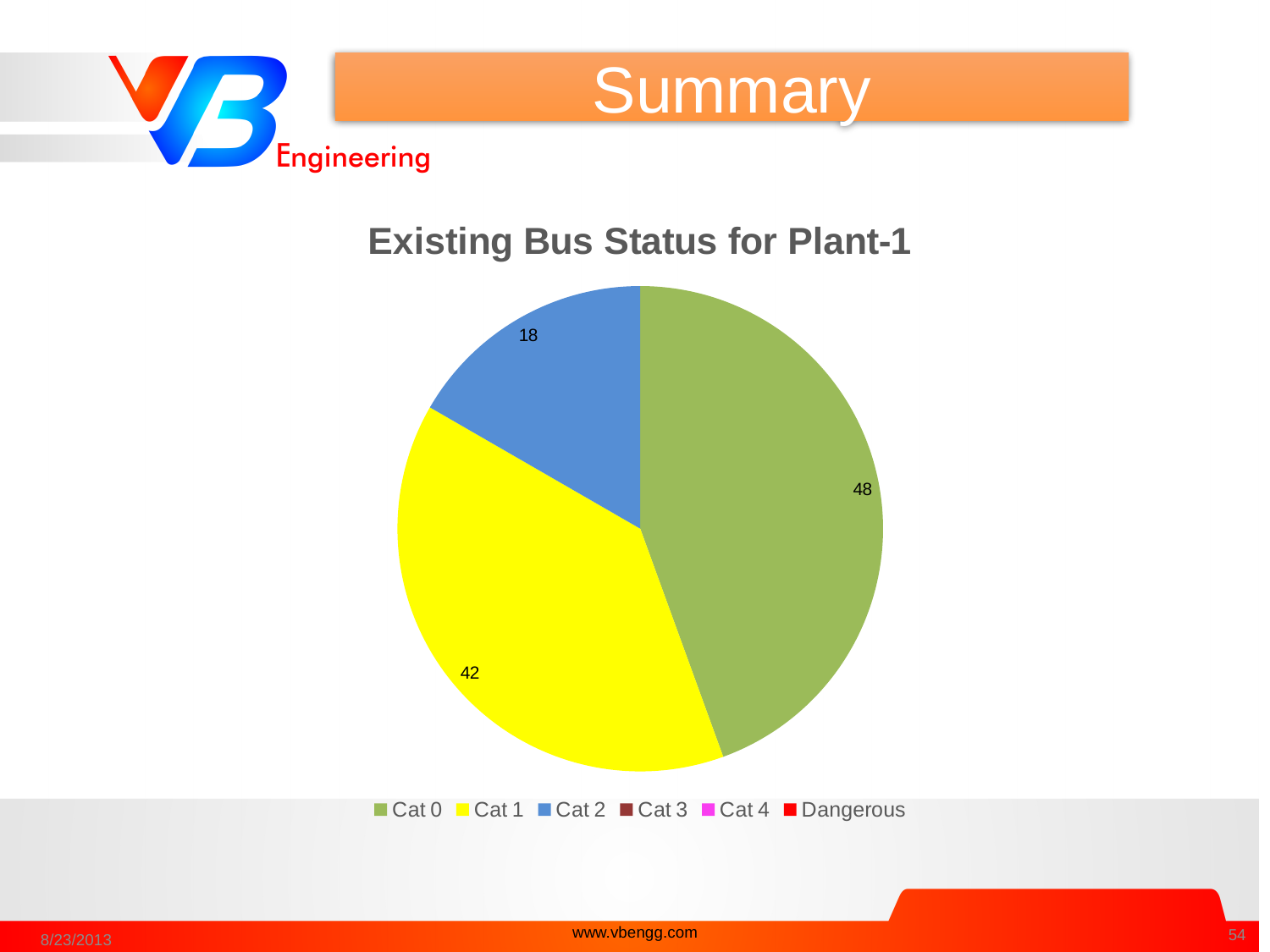
What is the value for Cat 2? 18 What is the difference between the values for Cat 0 and Cat 1? 6 What is the value for Cat 1? 42 What is the title of the chart? Existing Bus Status for Plant-1 What is the value for Cat 0? 48 How many slices with data labels are shown in the pie? 3 Which of the visible slices is the smallest? Cat 2 Which is larger, the value for Cat 1 or the value for Cat 2? Cat 1 What type of chart is shown on the slide? Pie chart Which category has the largest slice of the pie? Cat 0 What is the difference between the values for Cat 1 and Cat 2? 24 How many entries does the legend list? 6